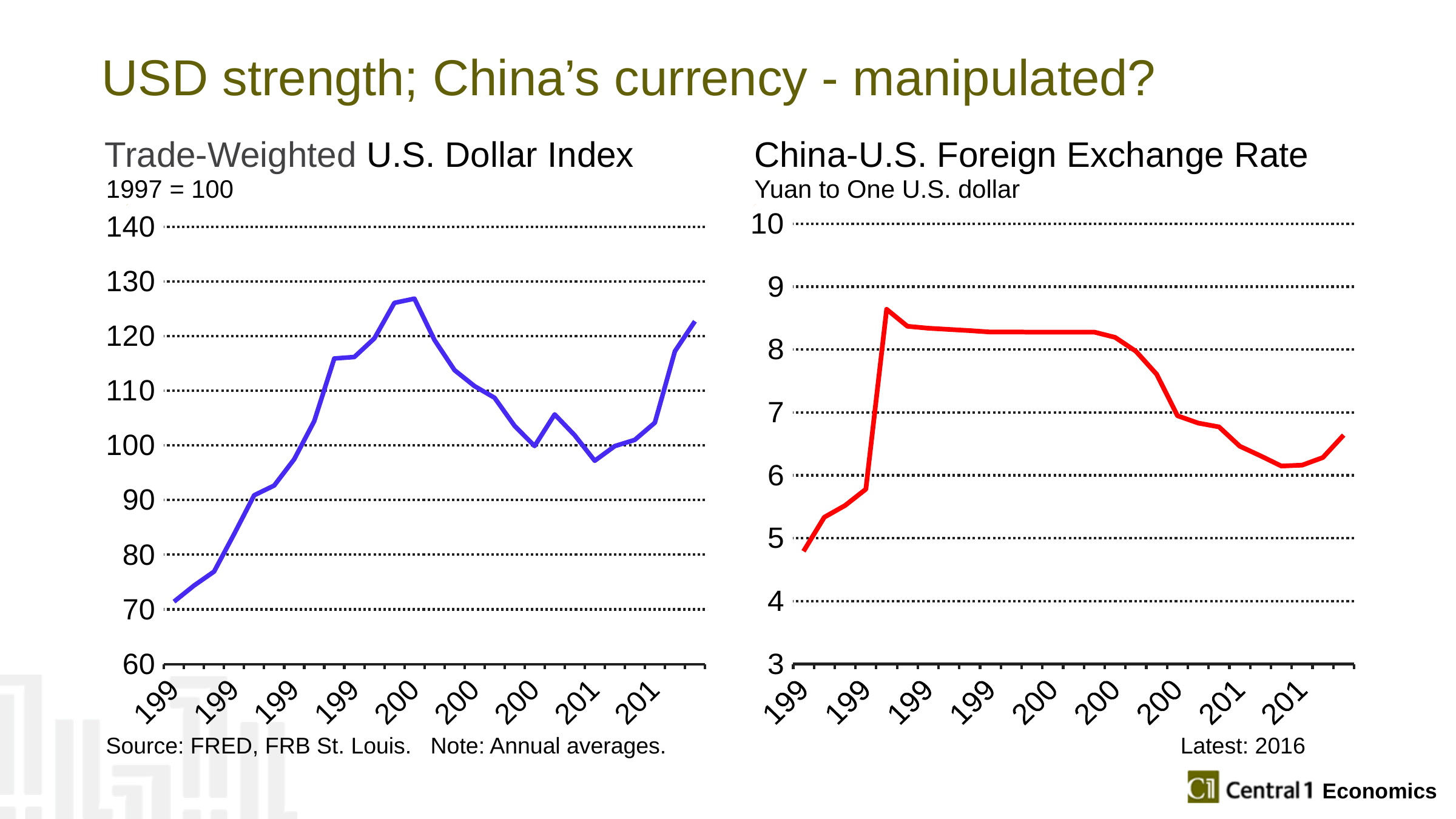
In the China-U.S. Foreign Exchange Rate chart, is the last plotted value greater or less than 7? less In the Trade-Weighted U.S. Dollar Index chart, is the last plotted value greater or less than 110? greater In the Trade-Weighted U.S. Dollar Index chart, is the last plotted value higher or lower than the first plotted value? higher In the Trade-Weighted U.S. Dollar Index chart, is the first plotted value greater or less than 80? less What kind of chart is the China-U.S. Foreign Exchange Rate chart? line chart In the China-U.S. Foreign Exchange Rate chart, does the line rise or fall from its peak to the end of the series? fall What is the subtitle shown under the Trade-Weighted U.S. Dollar Index chart title? 1997 = 100 What colour is the line in the China-U.S. Foreign Exchange Rate chart? red What kind of chart is the Trade-Weighted U.S. Dollar Index chart? line chart